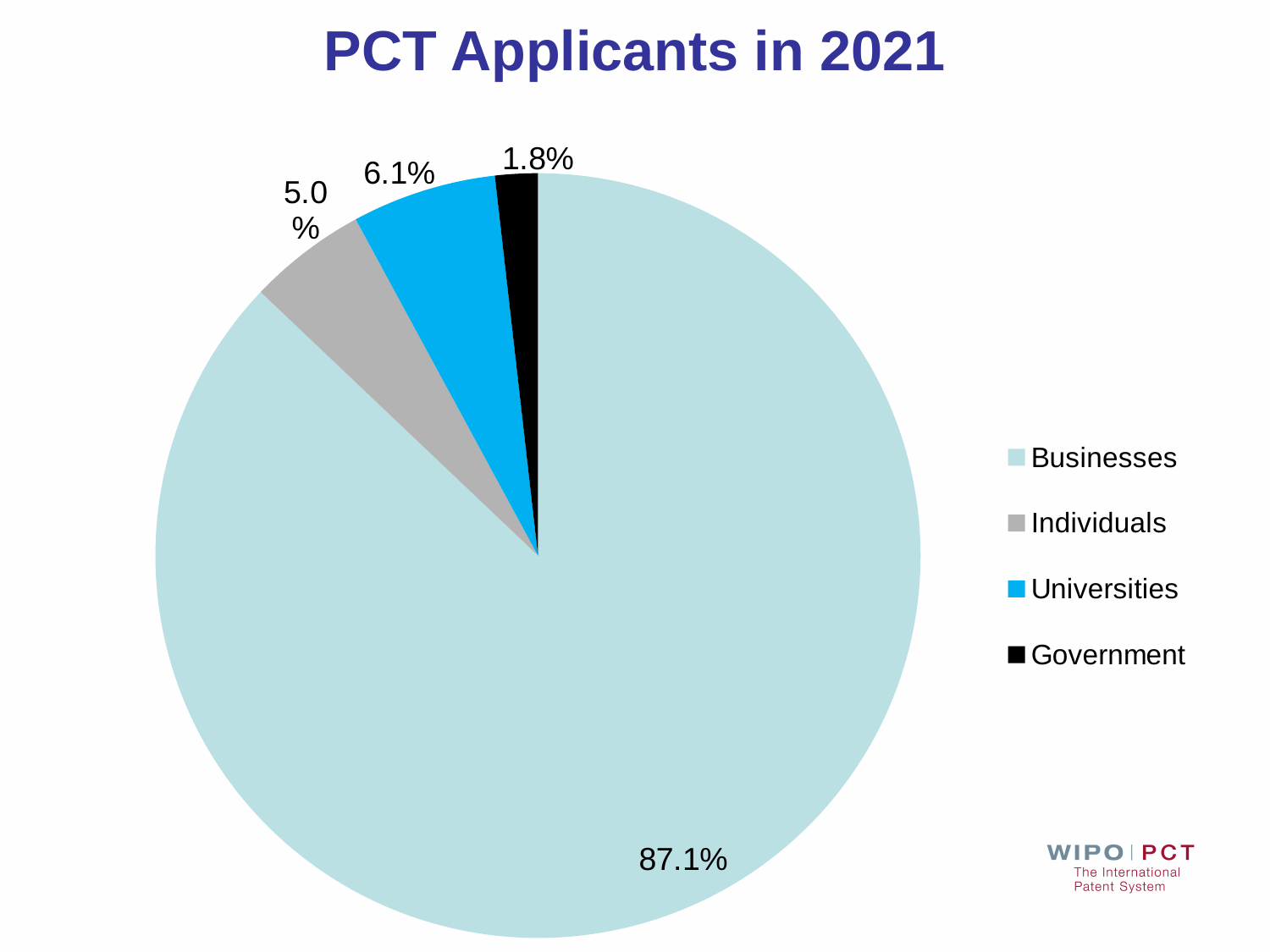
Which is larger, the share for Universities or the share for Individuals? Universities What is the title of the chart? PCT Applicants in 2021 What is the difference in percentage points between the Universities share and the Government share? 4.3 Which category has the largest share of the pie? Businesses What share of PCT applicants in 2021 were Individuals? 5.0% What type of chart is shown on the slide? Pie chart How many categories does the pie chart show? 4 What share of PCT applicants in 2021 were Businesses? 87.1% What share of PCT applicants in 2021 were Government? 1.8% Which colour represents Universities in the legend? Blue Which category has the smallest share of the pie? Government